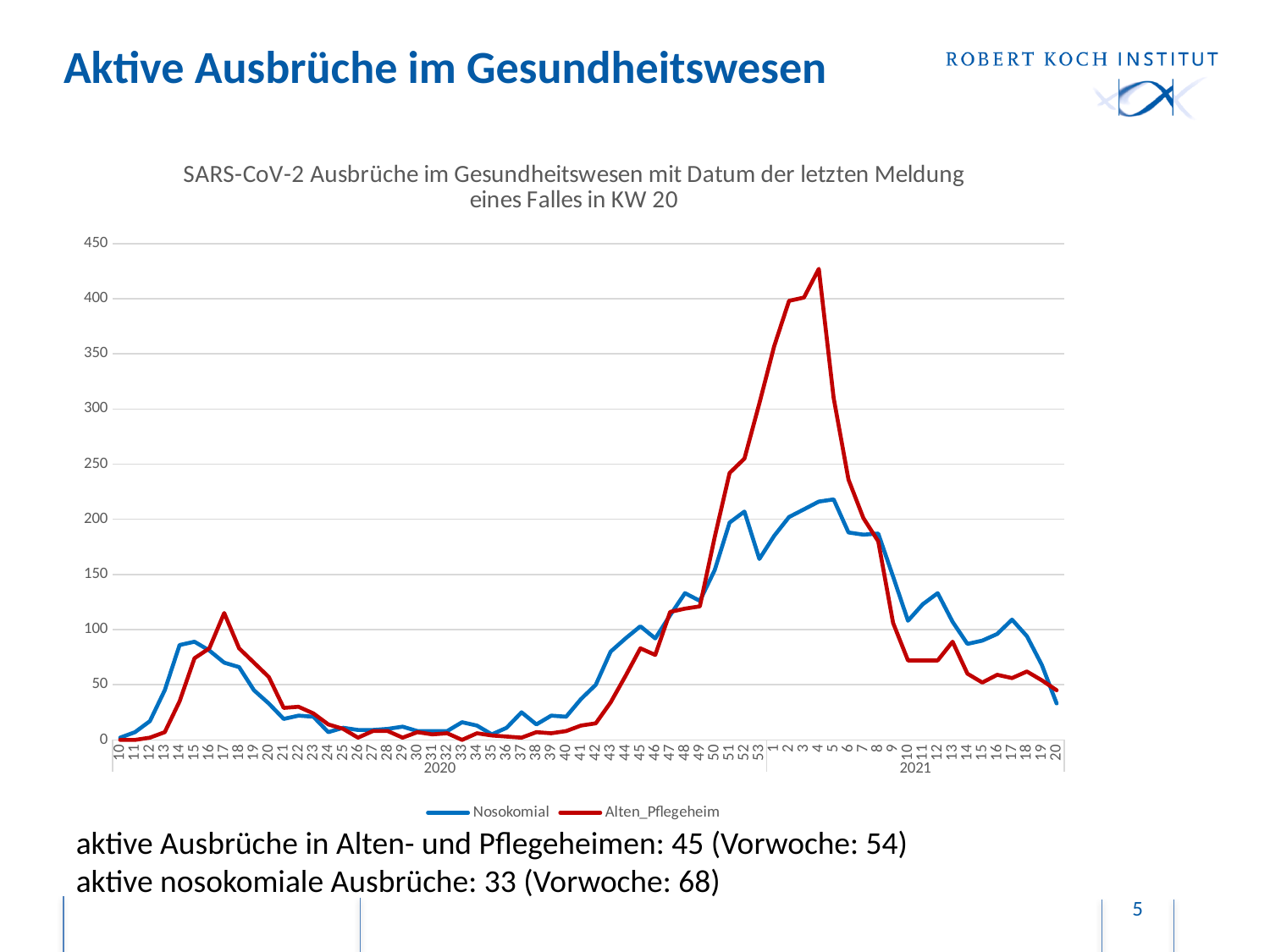
At KW 20 of 2021, how much higher is the Alten_Pflegeheim value than the Nosokomial value? 12 How many series does the chart's legend list? 2 At KW 15 of 2020, which series has the higher value, Nosokomial or Alten_Pflegeheim? Nosokomial What is the value of the Alten_Pflegeheim series at KW 20 of 2021? 45 What kind of chart is shown on the slide? line chart What is the title of the chart? SARS-CoV-2 Ausbrüche im Gesundheitswesen mit Datum der letzten Meldung eines Falles in KW 20 Which series reaches the highest value anywhere on the chart? Alten_Pflegeheim What are the two series named in the chart's legend? Nosokomial and Alten_Pflegeheim From KW 4 of 2021 to KW 20 of 2021, does the Alten_Pflegeheim series rise or fall? fall Is the value of the Nosokomial series at KW 4 of 2021 greater or less than 250? less What is the value of the Nosokomial series at KW 20 of 2021? 33 Is the peak value of the Alten_Pflegeheim series at KW 4 of 2021 greater or less than 400? greater